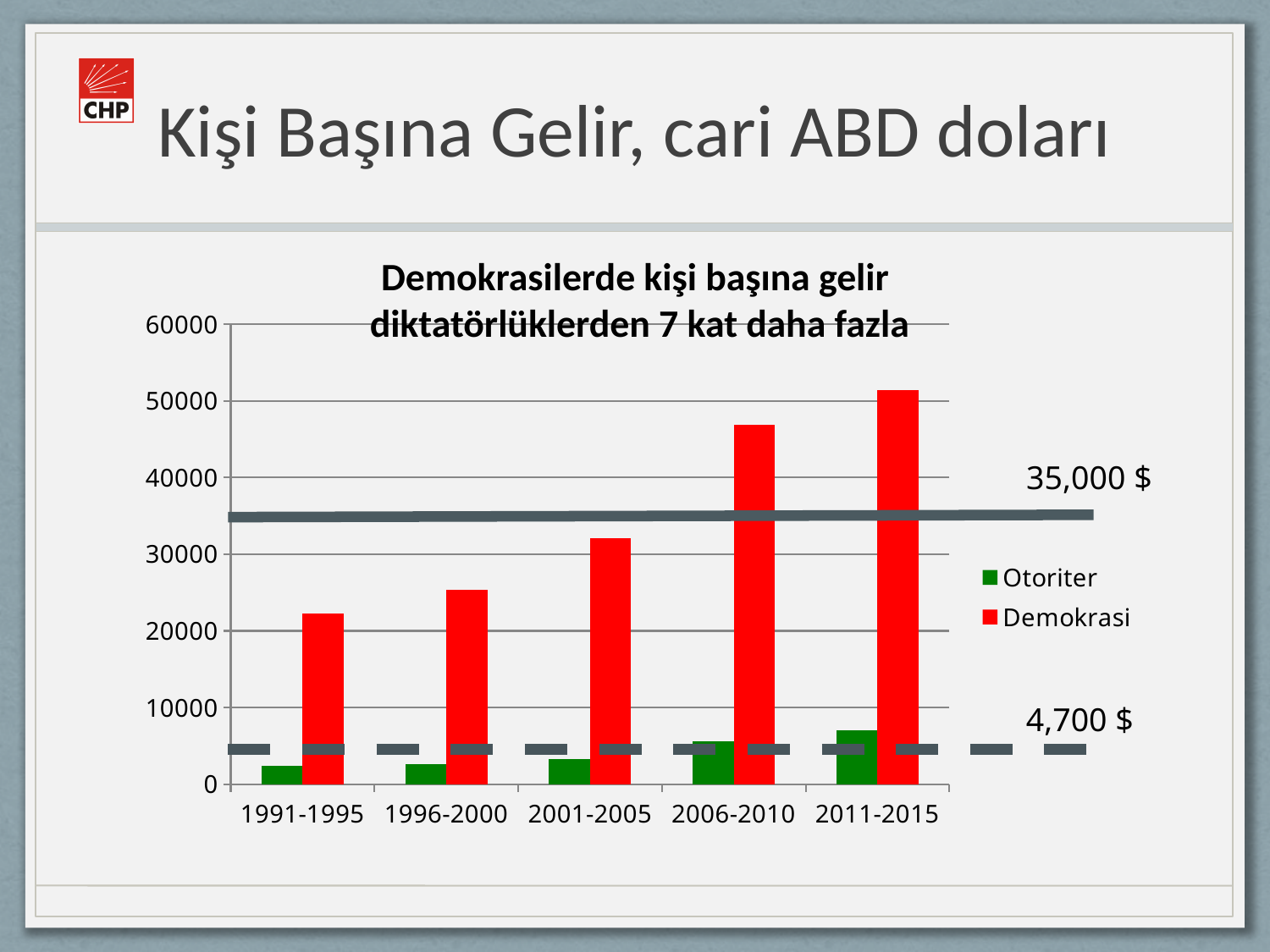
Is the Otoriter value for 2011-2015 greater or less than 10000? less Which period has the highest Otoriter value? 2011-2015 How many series does the legend list? 2 How many time periods are shown on the x axis? 5 Which period has the lowest Demokrasi value? 1991-1995 Which period has the highest Demokrasi value? 2011-2015 What value is labelled on the solid horizontal reference line? 35,000 $ Which is larger in 2001-2005, the Otoriter value or the Demokrasi value? Demokrasi Do the Demokrasi values rise or fall from 1991-1995 to 2011-2015? rise What is the title of the chart? Demokrasilerde kişi başına gelir diktatörlüklerden 7 kat daha fazla What kind of chart is shown on the slide? bar chart Is the Demokrasi value for 2006-2010 greater or less than 40000? greater